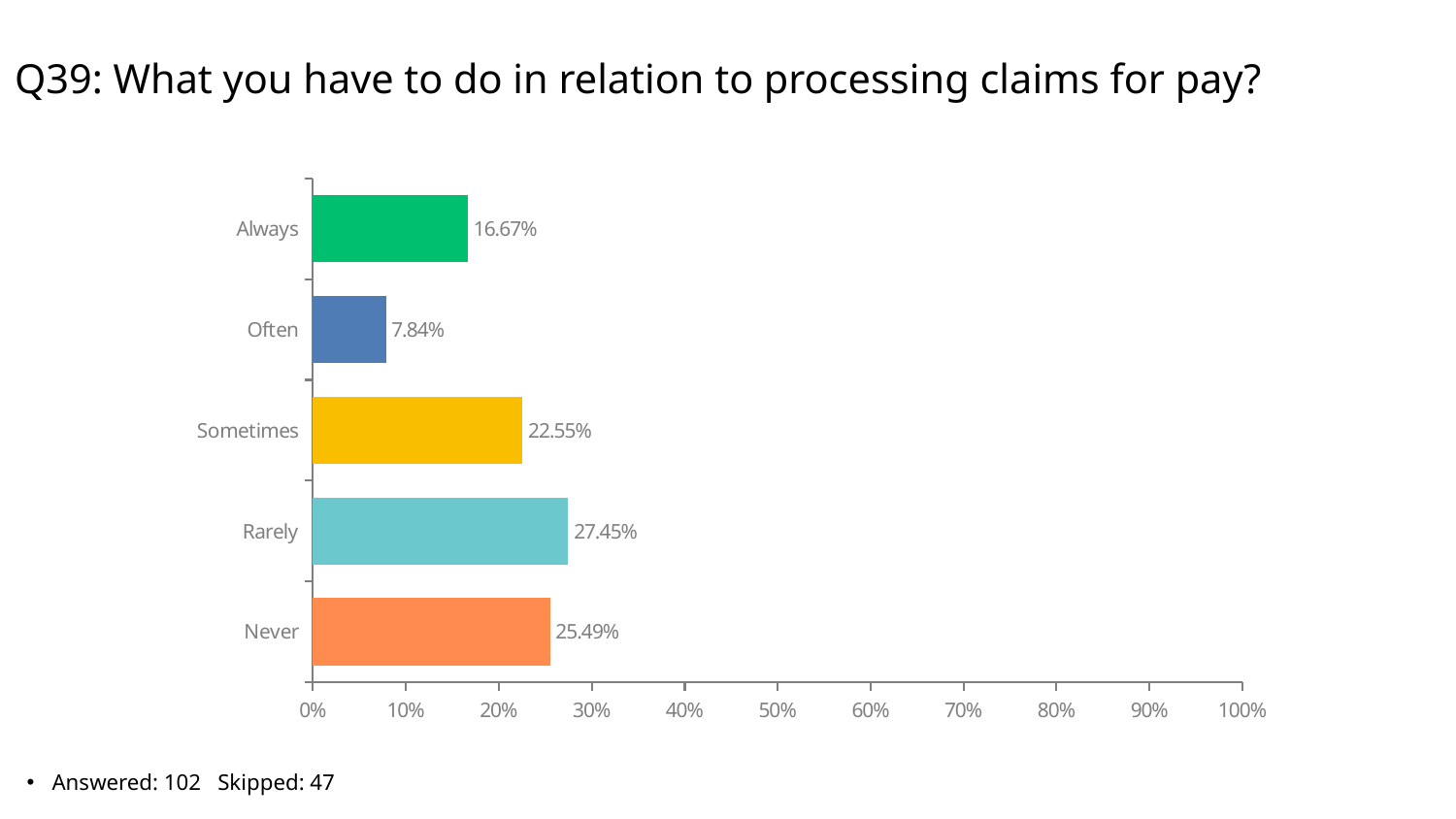
What is the value for Never? 25.49% What is the value for Sometimes? 22.55% What is the difference between the values for Always and Often? 8.83% What is the value for Often? 7.84% Is the value for Rarely greater or less than 20%? greater What is the difference between the values for Rarely and Never? 1.96% How many categories are shown in the chart? 5 Which category has the lowest value? Often What is the value for Always? 16.67% What kind of chart is shown on the slide? Bar chart Which is larger, the value for Sometimes or the value for Always? Sometimes Which category has the highest value? Rarely